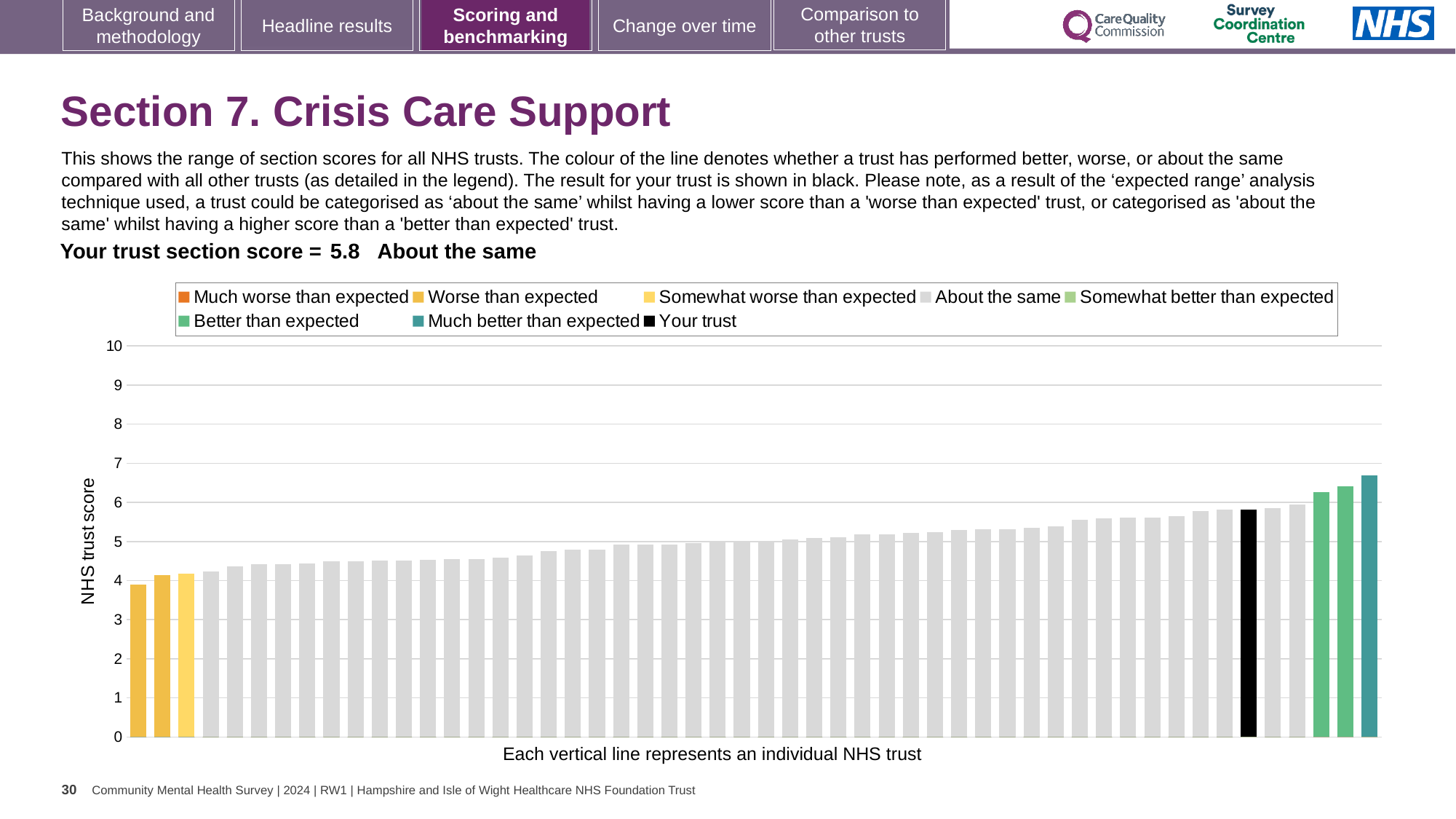
Which performance category is your trust's section score placed in? About the same According to the x-axis label, what does each vertical line in the chart represent? An individual NHS trust Is the value of the tallest bar in the chart greater or less than 6? greater Do the bar values rise or fall from left to right along the x axis? Rise Is the value of the black bar (your trust) greater or less than 5? greater What type of chart is shown on the slide? Bar chart Which legend category does the shortest bar in the chart belong to? Worse than expected What is the label on the vertical axis of the chart? NHS trust score What is the section score for your trust shown on the slide? 5.8 How many entries does the chart legend list? 8 Which legend category does the tallest bar in the chart belong to? Much better than expected Is the value of the shortest bar in the chart greater or less than 5? less